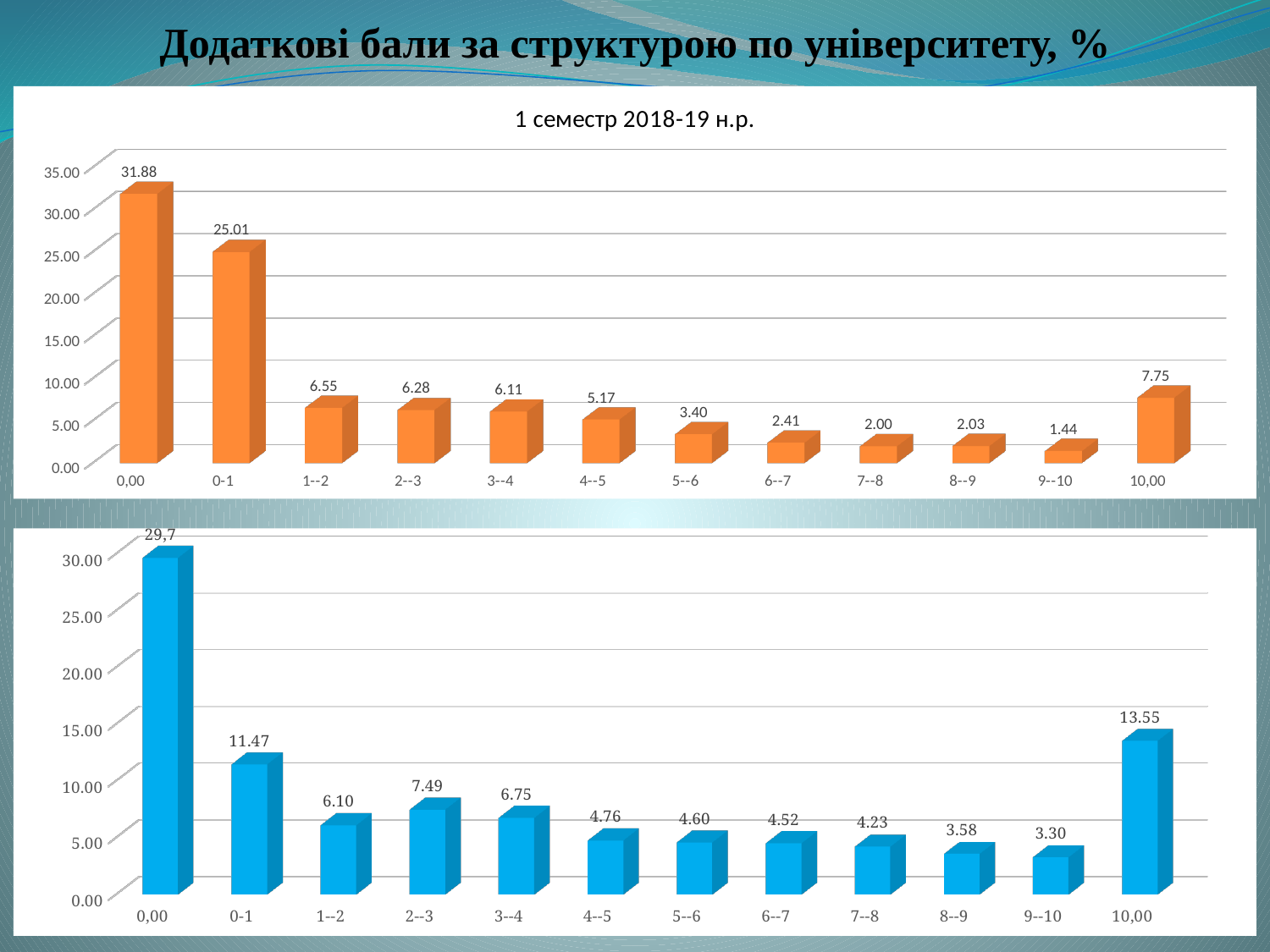
What type of chart is the bottom chart? Bar chart In the bottom chart, which is larger: the value for 2--3 or the value for 3--4? 2--3 In the top chart (1 семестр 2018-19 н.р.), what is the difference between the values for 0,00 and 0-1? 6.87 In the top chart (1 семестр 2018-19 н.р.), what is the value for the category 10,00? 7.75 In the top chart (1 семестр 2018-19 н.р.), how many categories are shown on the x axis? 12 In the top chart (1 семестр 2018-19 н.р.), which category has the lowest value? 9--10 In the bottom chart, what is the value for the category 0-1? 11.47 In the bottom chart, what is the value for the category 10,00? 13.55 In the top chart (1 семестр 2018-19 н.р.), what is the value for the category 0,00? 31.88 What colour are the bars in the top chart? Orange In the bottom chart, which category has the highest value? 0,00 In the bottom chart, what is the difference between the values for 10,00 and 0-1? 2.08